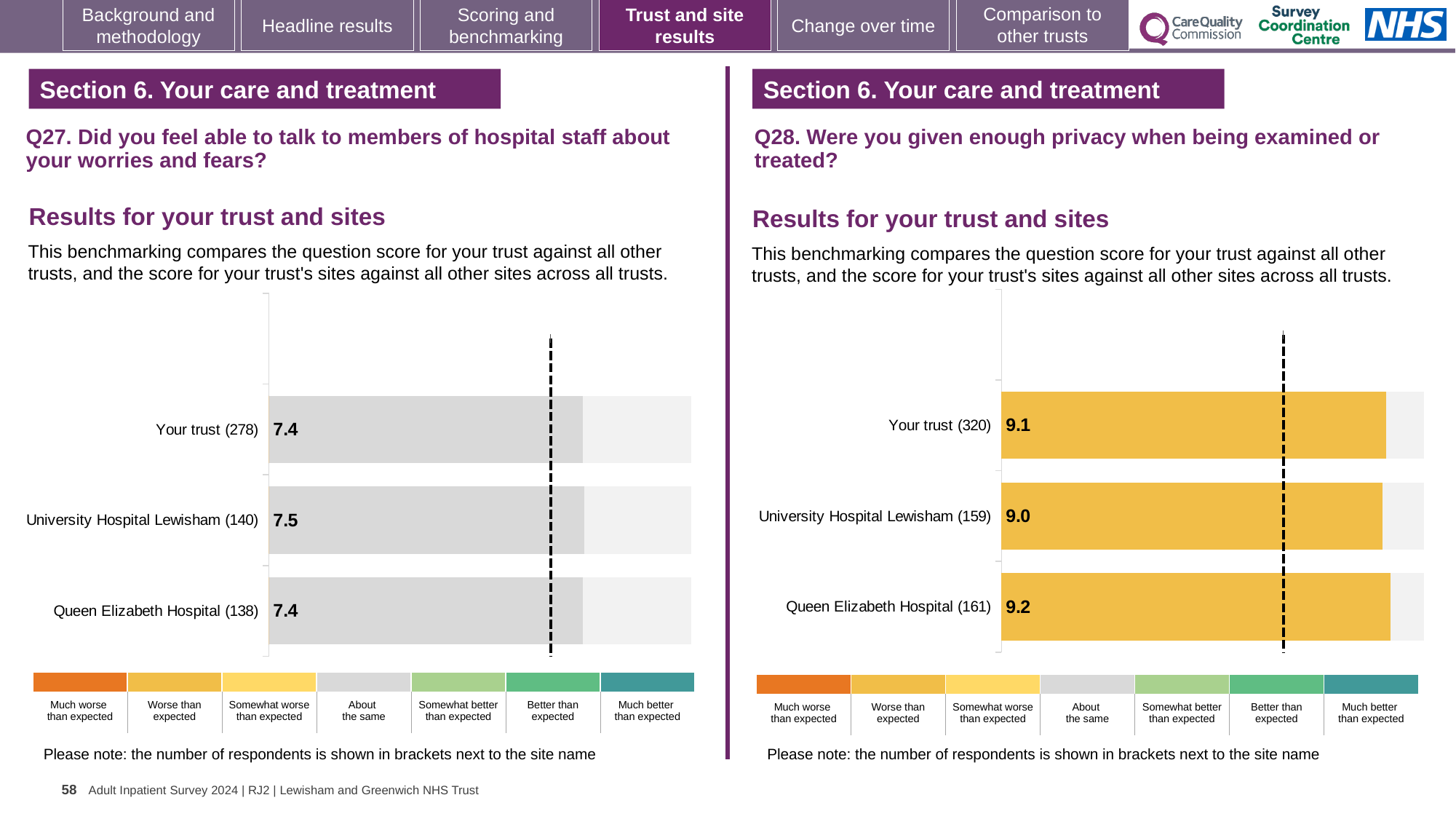
In the Q27 chart on the left, how many respondents are shown in brackets for Queen Elizabeth Hospital? 138 In the Q28 chart on the right, what is the difference between the scores for Queen Elizabeth Hospital and University Hospital Lewisham? 0.2 In the Q28 chart on the right, how many respondents are shown in brackets for Your trust? 320 In the Q28 chart on the right, what is the score for Queen Elizabeth Hospital? 9.2 What type of chart is used for the Q28 results on the right? Bar chart In the Q28 chart on the right, which site or trust has the lowest score? University Hospital Lewisham In the Q28 chart on the right, which site or trust has the highest score? Queen Elizabeth Hospital In the Q27 chart on the left, how many bars are plotted? 3 In the Q28 chart on the right, what is the score for University Hospital Lewisham? 9.0 In the Q27 chart on the left, what is the score for Your trust? 7.4 In the Q27 chart on the left, what is the score for University Hospital Lewisham? 7.5 In the Q27 chart on the left, which has the highest score? University Hospital Lewisham